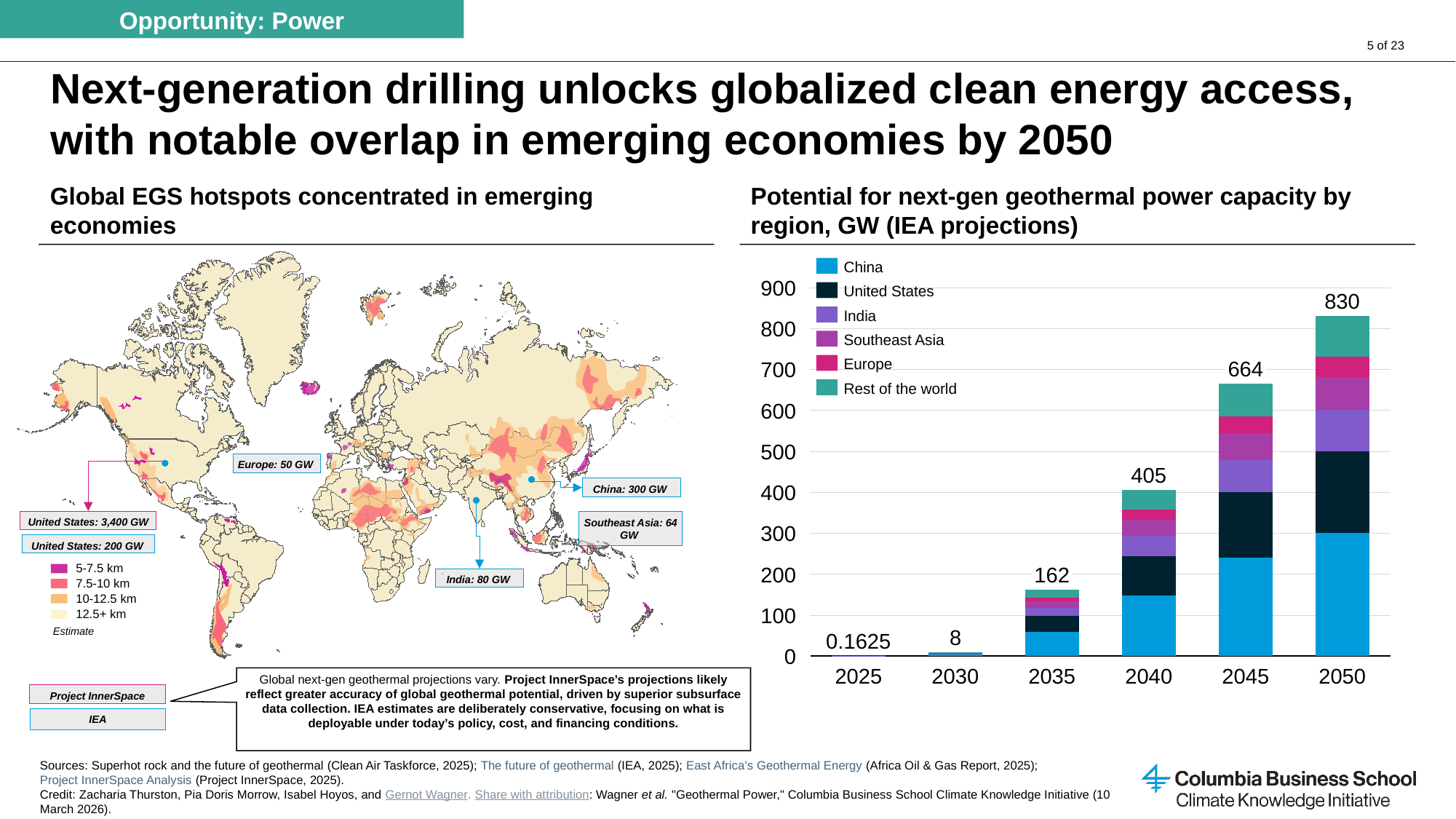
In the chart 'Potential for next-gen geothermal power capacity by region, GW (IEA projections)', what is the total value for 2030? 8 In the chart 'Potential for next-gen geothermal power capacity by region, GW (IEA projections)', how many series does the legend list? 6 In the chart 'Potential for next-gen geothermal power capacity by region, GW (IEA projections)', do the totals rise or fall from 2025 to 2050? Rise What kind of chart is 'Potential for next-gen geothermal power capacity by region, GW (IEA projections)'? Stacked bar chart In the chart 'Potential for next-gen geothermal power capacity by region, GW (IEA projections)', what is the total value for 2050? 830 In the chart 'Potential for next-gen geothermal power capacity by region, GW (IEA projections)', what is the total value for 2040? 405 In the chart 'Potential for next-gen geothermal power capacity by region, GW (IEA projections)', how many years are shown on the x axis? 6 In the chart 'Potential for next-gen geothermal power capacity by region, GW (IEA projections)', what is the difference between the 2045 total and the 2040 total? 259 In the chart 'Potential for next-gen geothermal power capacity by region, GW (IEA projections)', which year has the lowest total? 2025 In the chart 'Potential for next-gen geothermal power capacity by region, GW (IEA projections)', which year has the highest total? 2050 In the chart 'Potential for next-gen geothermal power capacity by region, GW (IEA projections)', what is the total value for 2025? 0.1625 In the chart 'Potential for next-gen geothermal power capacity by region, GW (IEA projections)', what is the difference between the 2050 total and the 2045 total? 166